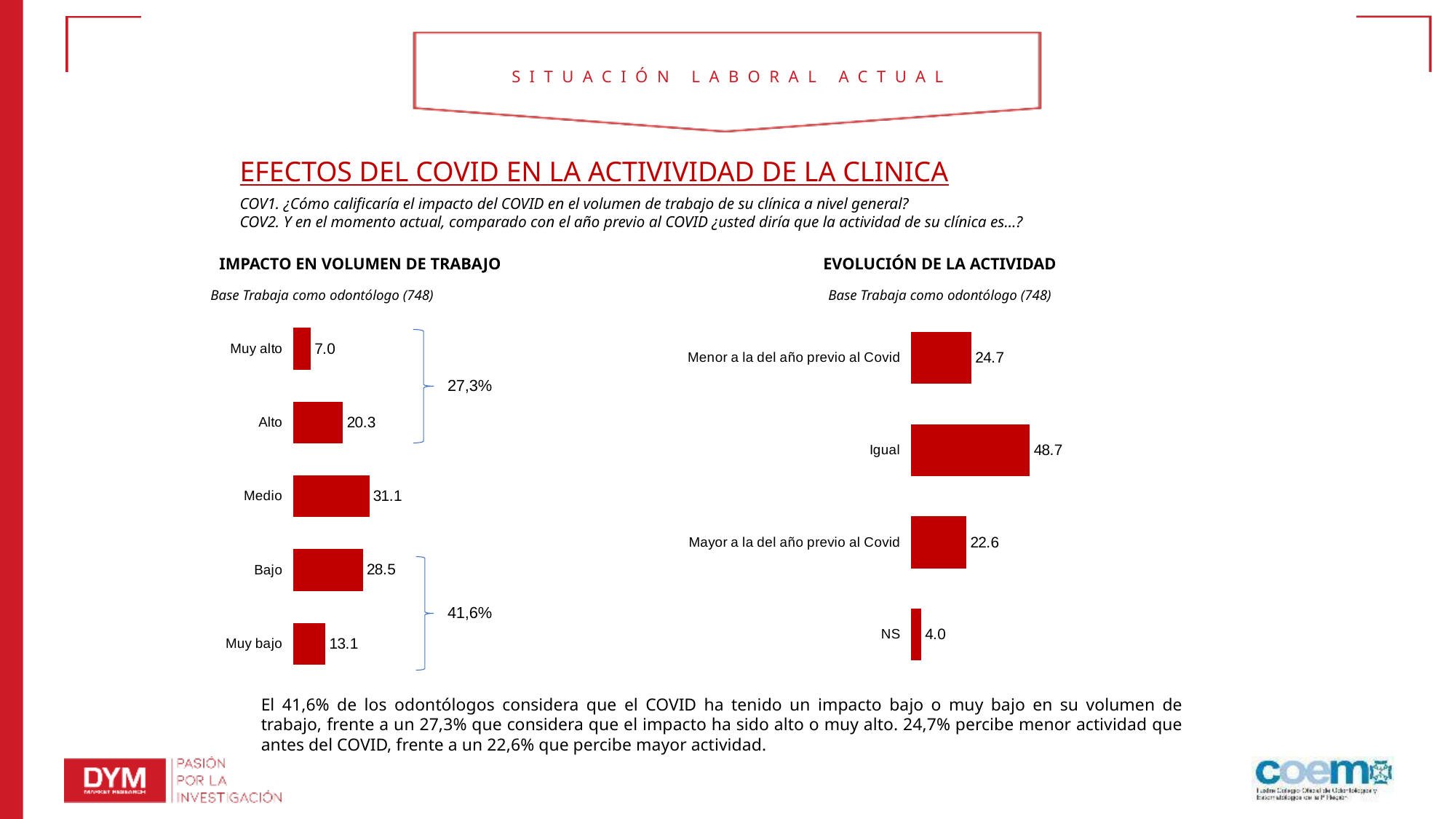
In the 'IMPACTO EN VOLUMEN DE TRABAJO' chart, how many categories are shown? 5 In the 'EVOLUCIÓN DE LA ACTIVIDAD' chart, what is the difference between 'Menor a la del año previo al Covid' and 'Mayor a la del año previo al Covid'? 2.1 In the 'IMPACTO EN VOLUMEN DE TRABAJO' chart, what is the value for Muy alto? 7.0 In the 'IMPACTO EN VOLUMEN DE TRABAJO' chart, what combined percentage is shown by the bracket grouping Bajo and Muy bajo? 41,6% In the 'EVOLUCIÓN DE LA ACTIVIDAD' chart, what is the value for NS? 4.0 In the 'IMPACTO EN VOLUMEN DE TRABAJO' chart, what is the difference between Bajo and Muy bajo? 15.4 What type of chart is the 'EVOLUCIÓN DE LA ACTIVIDAD' chart? Bar chart In the 'IMPACTO EN VOLUMEN DE TRABAJO' chart, which category has the highest value? Medio In the 'EVOLUCIÓN DE LA ACTIVIDAD' chart, what is the value for Igual? 48.7 In the 'IMPACTO EN VOLUMEN DE TRABAJO' chart, what is the value for Medio? 31.1 In the 'EVOLUCIÓN DE LA ACTIVIDAD' chart, which is larger: 'Menor a la del año previo al Covid' or 'Mayor a la del año previo al Covid'? Menor a la del año previo al Covid In the 'IMPACTO EN VOLUMEN DE TRABAJO' chart, which category has the lowest value? Muy alto